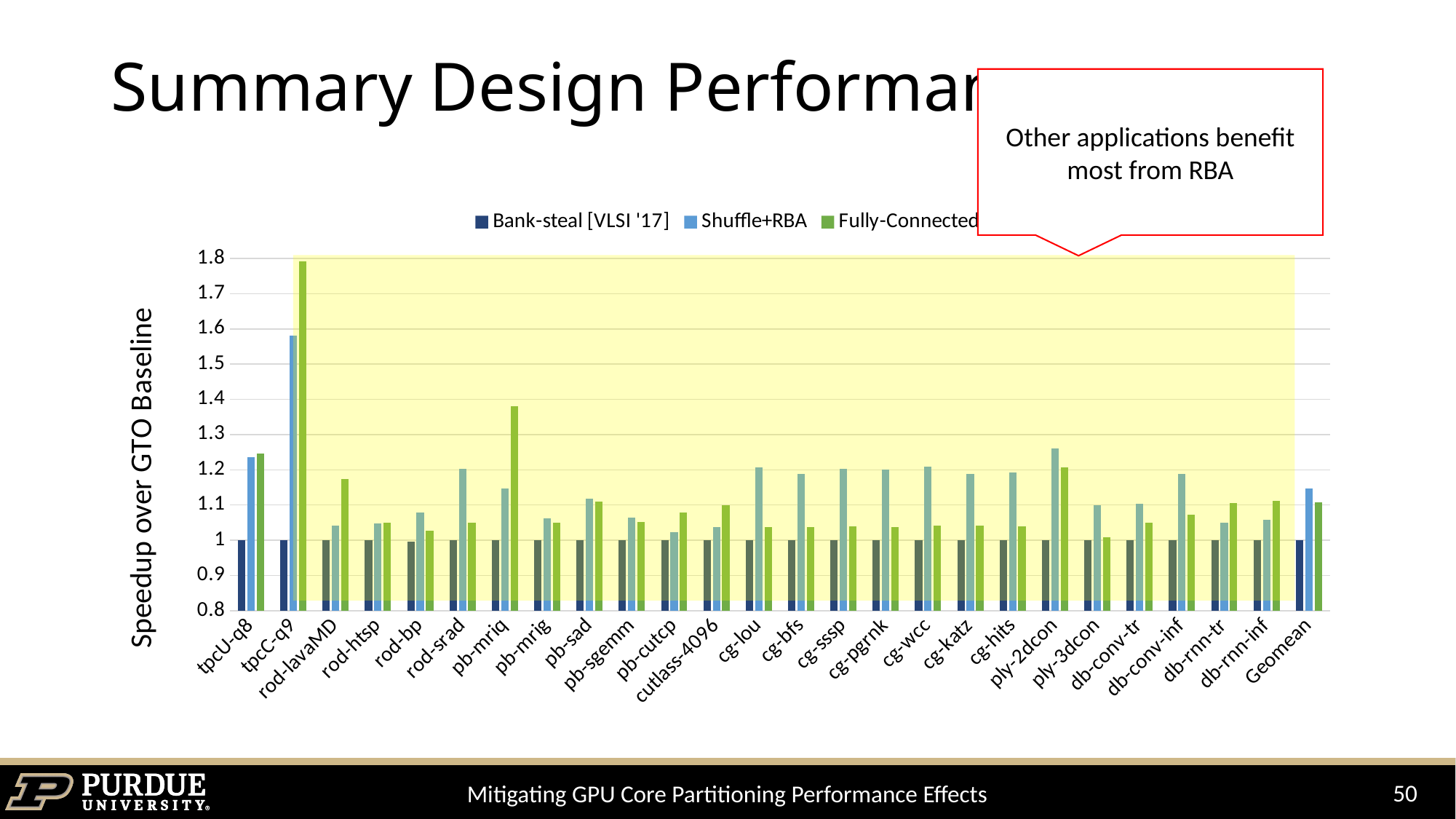
For which category is the Fully-Connected value highest? tpcC-q9 What is the label of the y axis? Speedup over GTO Baseline How many series does the legend list? 3 What is the value of the Bank-steal [VLSI '17] series for Geomean? 1 How many categories are shown along the x axis? 26 Is the Fully-Connected value for tpcC-q9 greater or less than 1.7? greater What kind of chart is shown on the slide? bar chart For which category is the Shuffle+RBA value highest? tpcC-q9 For pb-mriq, which is larger: the Shuffle+RBA value or the Fully-Connected value? Fully-Connected For cg-lou, which is larger: the Shuffle+RBA value or the Fully-Connected value? Shuffle+RBA Is the Fully-Connected value for pb-mriq greater or less than 1.3? greater Is the Shuffle+RBA value for tpcC-q9 greater or less than 1.5? greater